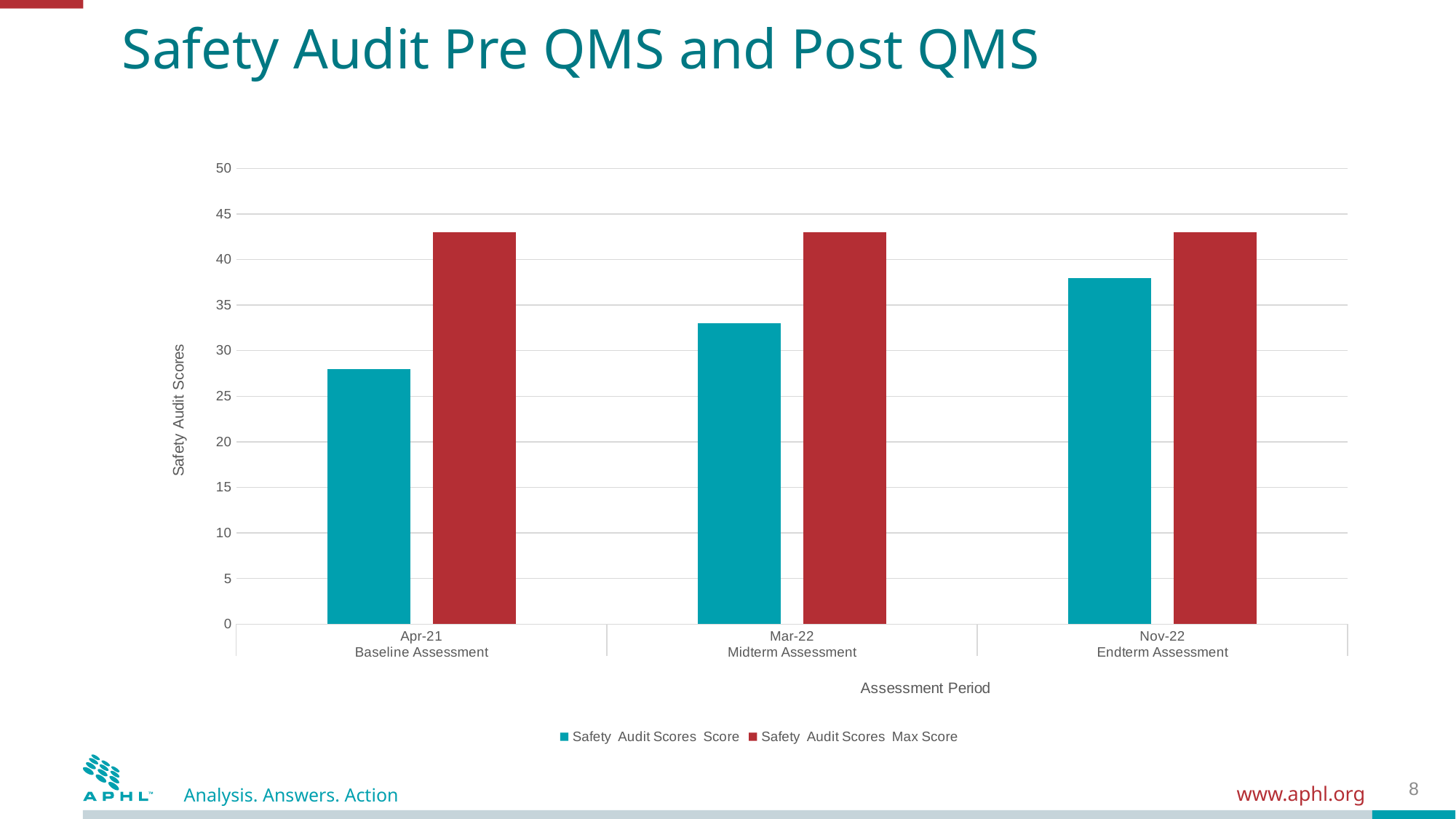
Is the Safety Audit Scores Max Score for Apr-21 Baseline Assessment greater or less than 40? greater How many series does the legend list? 2 Do the Safety Audit Scores Score values rise or fall from Apr-21 to Nov-22? rise How many assessment periods are shown on the x axis? 3 Is the Safety Audit Scores Score for Mar-22 Midterm Assessment greater or less than 30? greater Which assessment period has the highest Safety Audit Scores Score? Nov-22 Endterm Assessment For Mar-22 Midterm Assessment, which is larger: the Score or the Max Score? Max Score Is the Safety Audit Scores Score for Apr-21 Baseline Assessment greater or less than 30? less What kind of chart is shown on the slide? bar chart What is the title of the vertical axis? Safety Audit Scores Which assessment period has the lowest Safety Audit Scores Score? Apr-21 Baseline Assessment